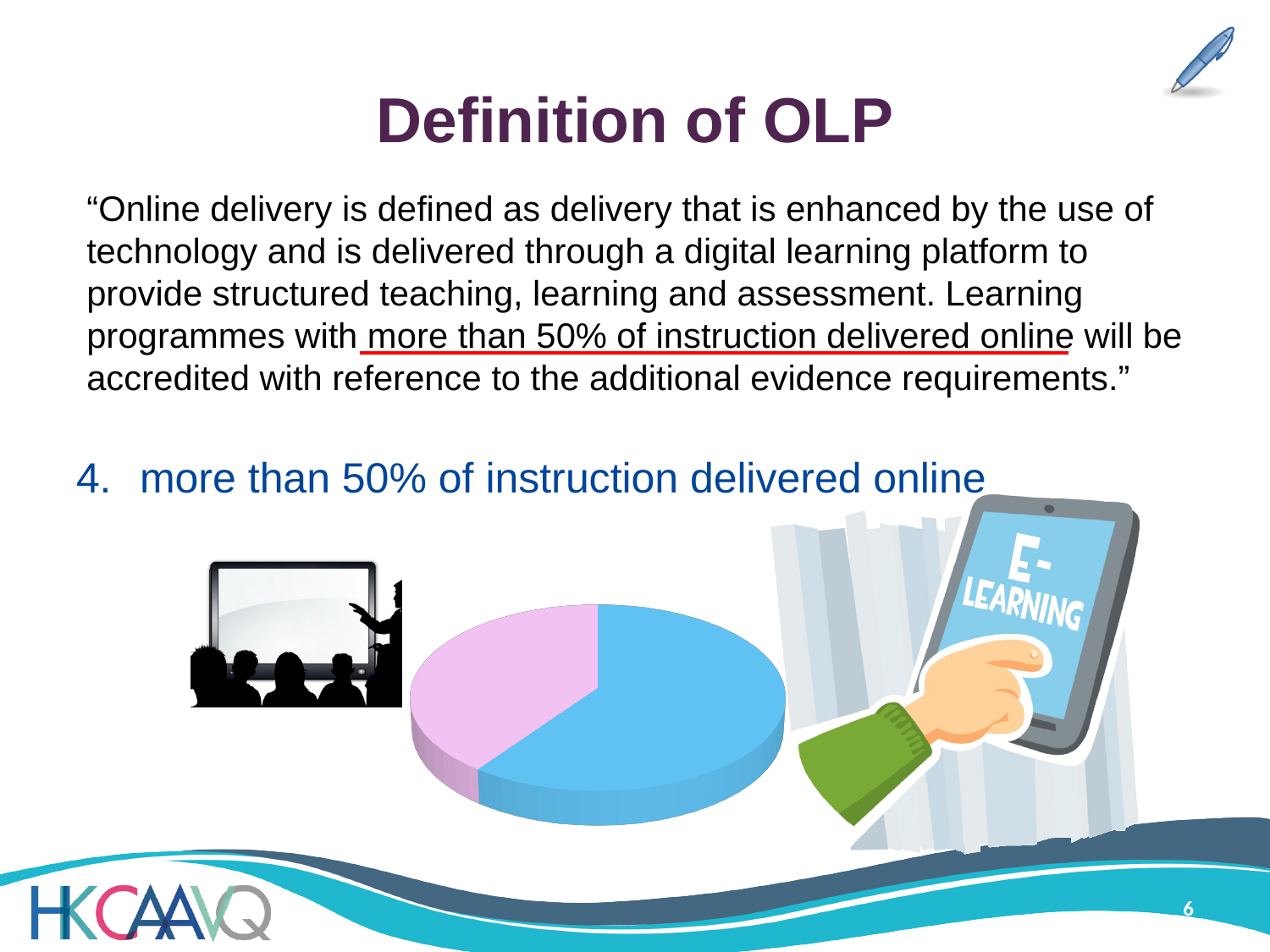
How many slices does the pie chart have? 2 Which colour slice takes up the largest share of the pie chart? blue What kind of chart is shown on the slide? pie chart Does the pie chart have a legend? No Which colour slice takes up the smallest share of the pie chart? pink Which slice of the pie chart is larger, the blue one or the pink one? the blue one What two colours are used for the slices of the pie chart? blue and pink